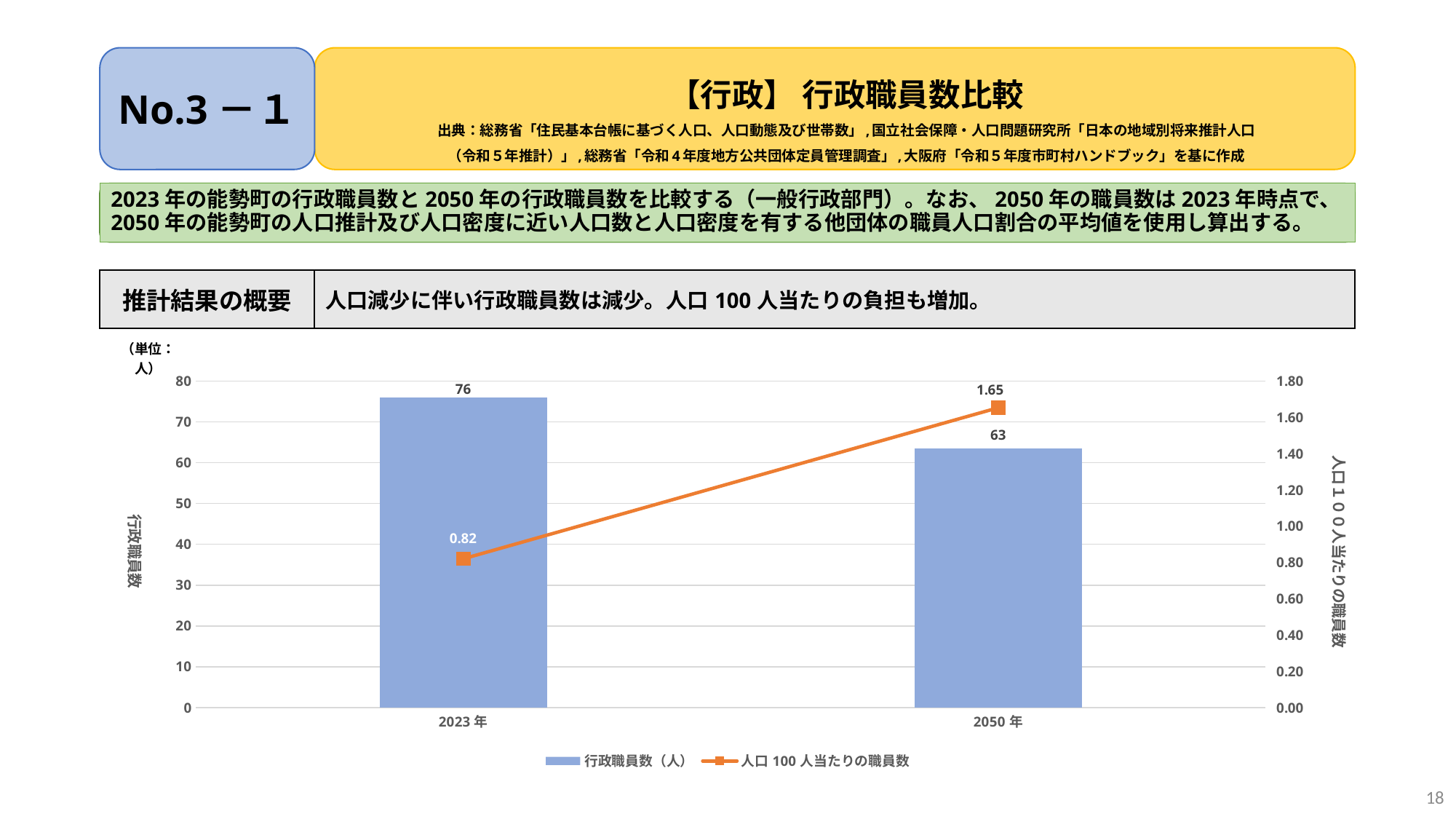
What is the difference in 行政職員数（人） between 2023年 and 2050年? 13 Which year has the lower 人口100人当たりの職員数? 2023年 Does 人口100人当たりの職員数 rise or fall from 2023年 to 2050年? rise What is the value of 行政職員数（人） for 2050年? 63 What is the value of 人口100人当たりの職員数 for 2050年? 1.65 Does 行政職員数（人） rise or fall from 2023年 to 2050年? fall What is the value of 行政職員数（人） for 2023年? 76 How many series does the legend list? 2 Which year has the higher 行政職員数（人）? 2023年 What is the difference in 人口100人当たりの職員数 between 2050年 and 2023年? 0.83 How many categories are shown on the x axis? 2 What is the value of 人口100人当たりの職員数 for 2023年? 0.82